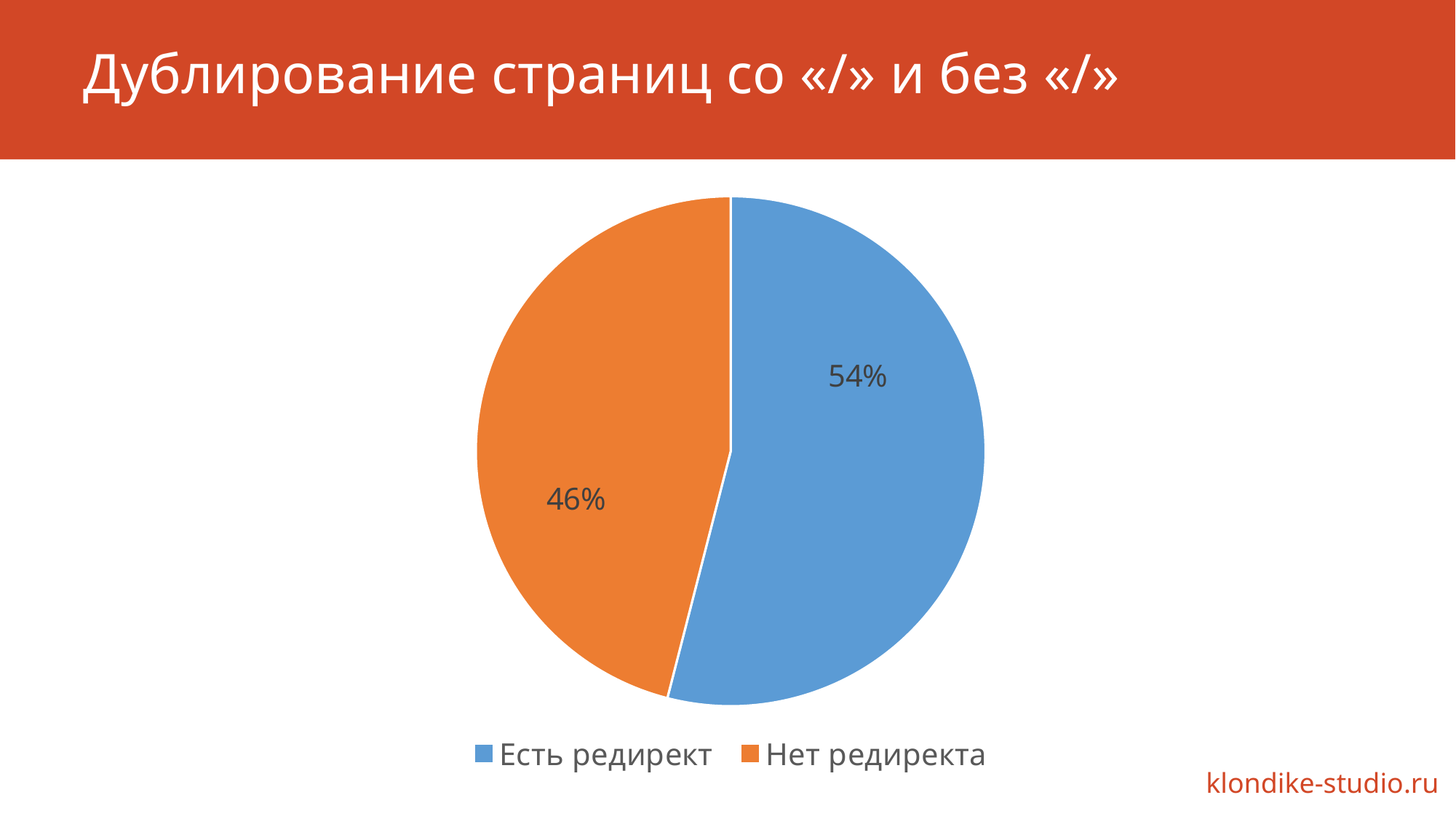
How many slices does the pie chart have? 2 What is the difference in percentage points between "Есть редирект" and "Нет редиректа"? 8 How many entries does the legend list? 2 What share of the pie does "Есть редирект" have? 54% What colour is the "Нет редиректа" slice? orange What share of the pie does "Нет редиректа" have? 46% What is the title of the slide containing the chart? Дублирование страниц со «/» и без «/» Which slice is the smallest? Нет редиректа Which is larger, "Есть редирект" or "Нет редиректа"? Есть редирект Which slice is the largest? Есть редирект What kind of chart is shown on the slide? pie chart